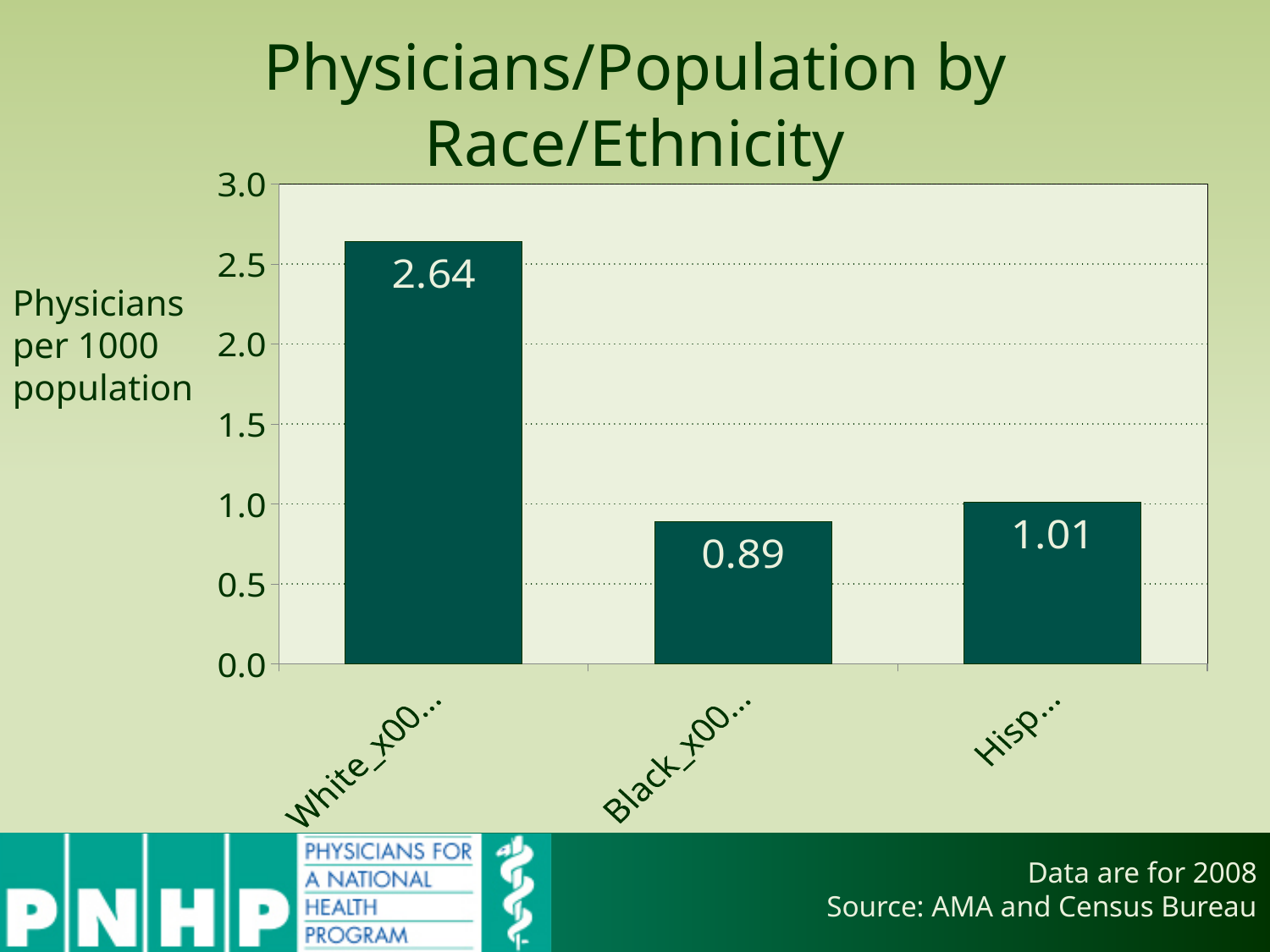
Which category has the lowest value? Black What is the difference between the rightmost bar (Hisp...) and the Black bar? 0.12 Which is larger, the value for Black or the value for the rightmost bar (Hisp...)? Hisp... (1.01) What is the value for the White category? 2.64 Which category has the highest value? White What is the title of the chart? Physicians/Population by Race/Ethnicity Is the value for White greater or less than 2.5? greater What is the difference between the White and Black values? 1.75 What is the value shown on the rightmost bar (labelled Hisp...)? 1.01 What kind of chart is shown on the slide? bar chart What is the value for the Black category? 0.89 How many bars are shown in the chart? 3